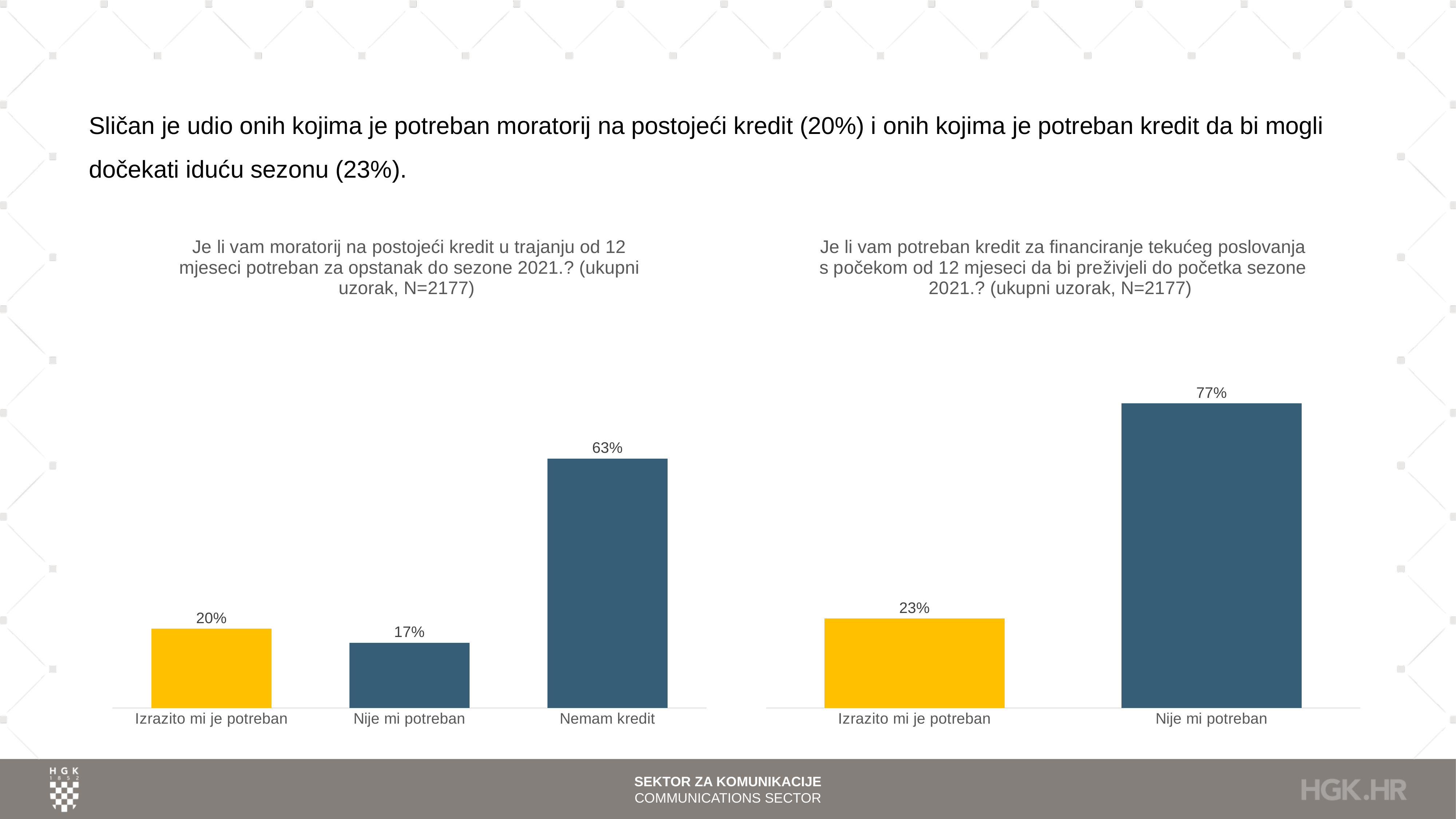
In the right chart (kredit za financiranje tekućeg poslovanja), what is the difference between 'Nije mi potreban' and 'Izrazito mi je potreban'? 54% In the left chart (moratorij na postojeći kredit), what is the value for 'Izrazito mi je potreban'? 20% In the left chart (moratorij na postojeći kredit), which category has the lowest value? Nije mi potreban What type of chart is the right chart (kredit za financiranje tekućeg poslovanja)? Bar chart In the left chart (moratorij na postojeći kredit), which category has the highest value? Nemam kredit In the right chart (kredit za financiranje tekućeg poslovanja), what is the value for 'Izrazito mi je potreban'? 23% In the right chart (kredit za financiranje tekućeg poslovanja), what is the value for 'Nije mi potreban'? 77% How many categories does the left chart (moratorij na postojeći kredit) show? 3 In the left chart (moratorij na postojeći kredit), what is the difference between 'Nemam kredit' and 'Izrazito mi je potreban'? 43% In the left chart (moratorij na postojeći kredit), what is the value for 'Nemam kredit'? 63% In the left chart (moratorij na postojeći kredit), what is the value for 'Nije mi potreban'? 17% In the right chart (kredit za financiranje tekućeg poslovanja), which category has the highest value? Nije mi potreban